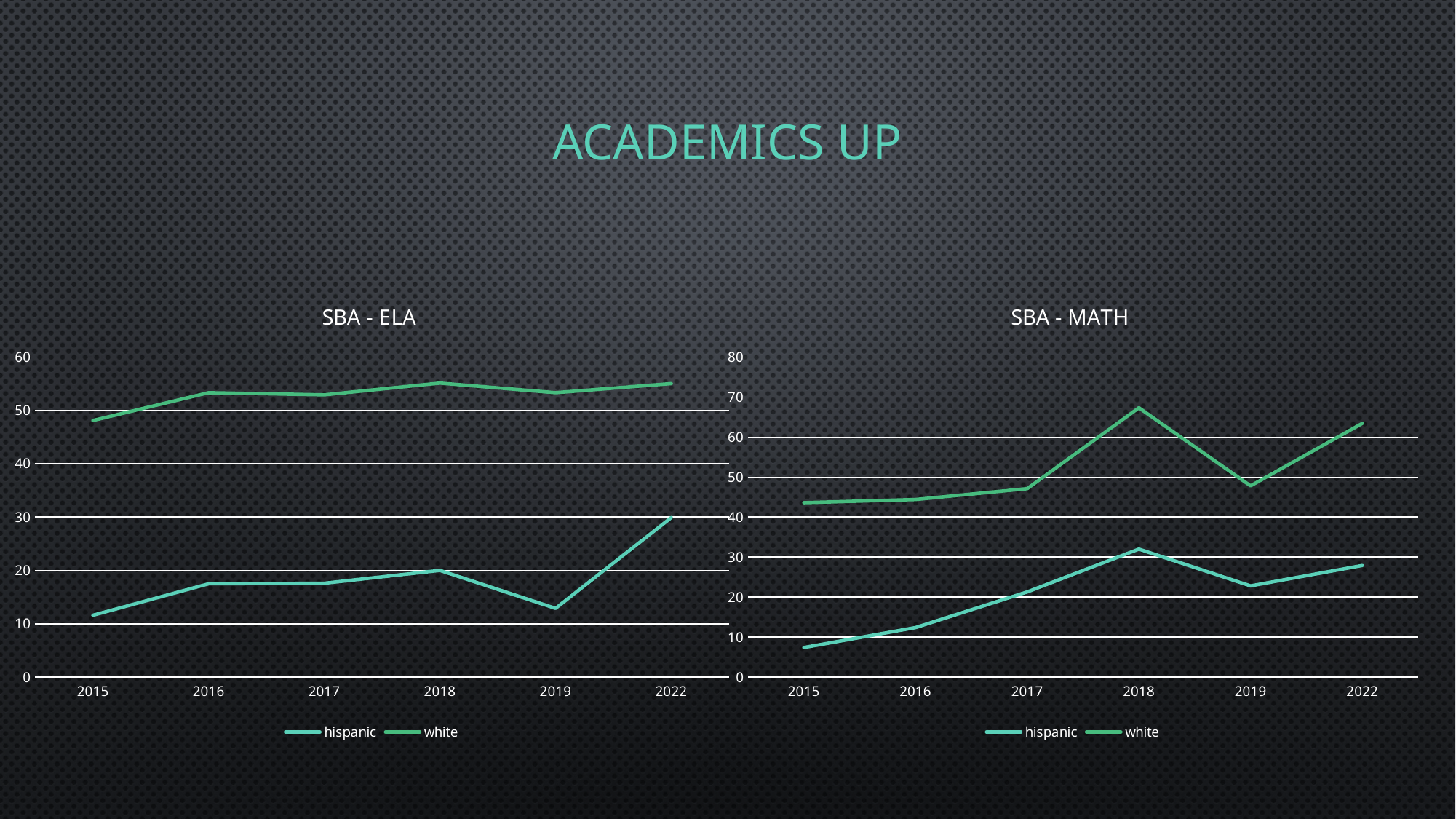
In the SBA - ELA chart, which year has the highest value for hispanic? 2022 In the SBA - MATH chart, which year has the highest value for white? 2018 In the SBA - MATH chart, does the hispanic line rise or fall from 2015 to 2018? rise In the SBA - MATH chart, is the value for hispanic in 2018 greater or less than 30? greater In the SBA - ELA chart, is the value for white in 2015 greater or less than 50? less In the SBA - MATH chart, which year has the lowest value for hispanic? 2015 How many years are shown on the x axis of the SBA - ELA chart? 6 In the SBA - ELA chart, which year has the lowest value for hispanic? 2015 What kind of chart is the SBA - ELA chart? line chart In the SBA - MATH chart, which is larger, the white value in 2018 or the white value in 2019? 2018 How many series does the legend of the SBA - MATH chart list? 2 What is the title of the chart on the right side of the slide? SBA - MATH